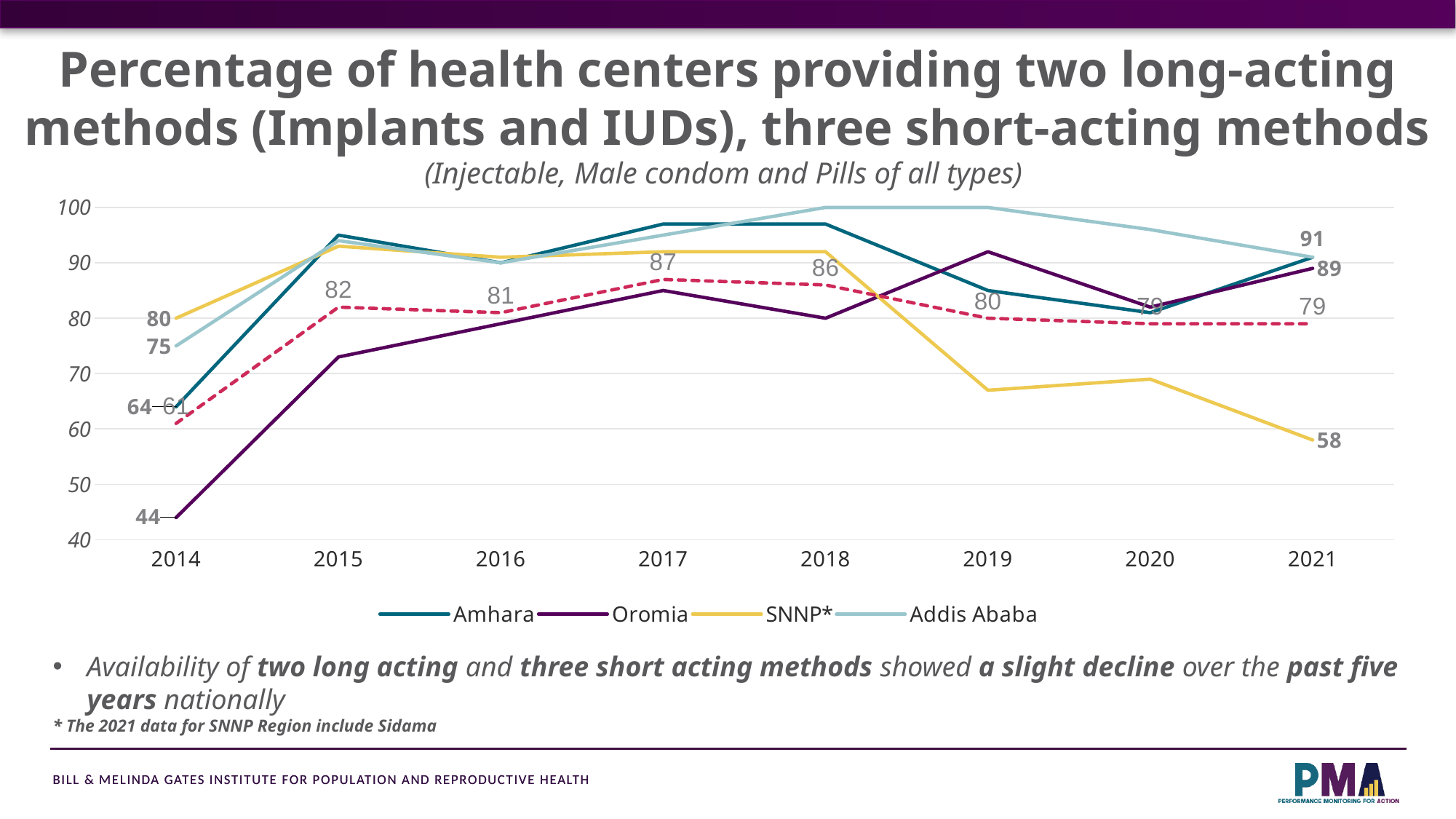
What is the value for SNNP* in 2021? 58 Is the value for SNNP* in 2019 greater or less than 70? less How many years are shown on the x axis? 8 What is the value for Addis Ababa in 2014? 75 Which is larger in 2021, the value for Oromia or the value for SNNP*? Oromia What is the value for Oromia in 2014? 44 Does the SNNP* line rise or fall from 2018 to 2021? fall What kind of chart is shown on the slide? line chart How many series does the legend list? 4 Which region has the lowest value in 2014? Oromia What is the value for Amhara in 2021? 91 What is the difference between the Amhara and Oromia values in 2014? 20